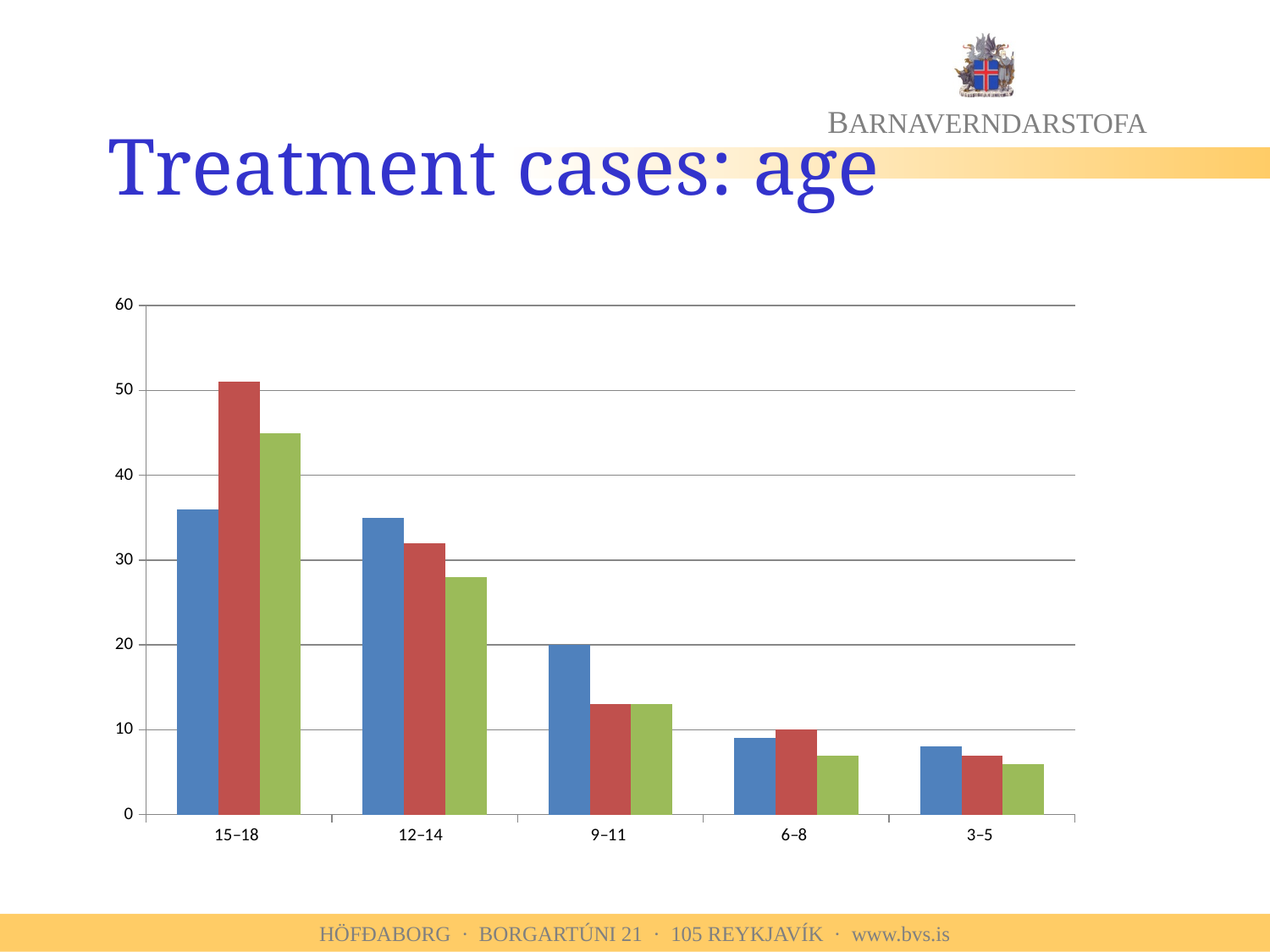
How many age groups are shown on the x axis? 5 Which is larger, the blue bar for 12–14 or the blue bar for 9–11? 12–14 Is the value of the red bar for 15–18 greater or less than 40? greater Is the value of the blue bar for 6–8 greater or less than 20? less In the 15–18 age group, which coloured bar is the tallest? red How many bars are plotted for each age group? 3 Is the value of the blue bar for 15–18 greater or less than 30? greater Do the blue bars rise or fall moving from 15–18 to 3–5 along the x axis? fall What is the title of the slide's chart? Treatment cases: age What kind of chart is shown on the slide? bar chart Which age group has the tallest red bar? 15–18